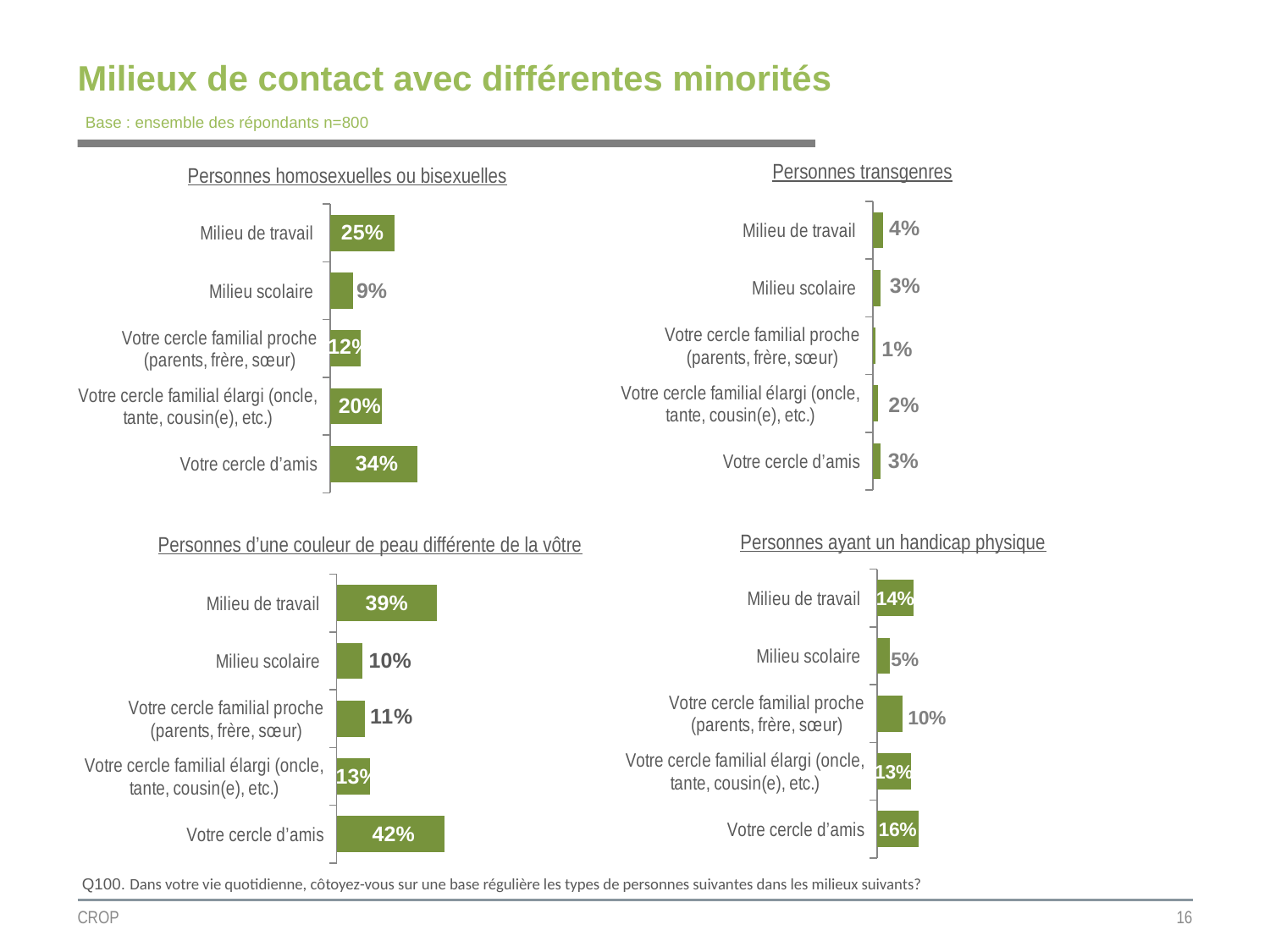
In the 'Personnes homosexuelles ou bisexuelles' chart, what is the value for 'Votre cercle d'amis'? 34% In the 'Personnes transgenres' chart, which category has the lowest value? Votre cercle familial proche (parents, frère, sœur) In the 'Personnes d'une couleur de peau différente de la vôtre' chart, which category has the highest value? Votre cercle d'amis How many charts are shown on the slide? 4 In the 'Personnes d'une couleur de peau différente de la vôtre' chart, what is the value for 'Milieu de travail'? 39% What type of chart is used for 'Personnes ayant un handicap physique'? Bar chart In the 'Personnes ayant un handicap physique' chart, what is the value for 'Milieu scolaire'? 5% In the 'Personnes transgenres' chart, what is the value for 'Milieu de travail'? 4% How many categories are shown in the 'Personnes transgenres' chart? 5 In the 'Personnes homosexuelles ou bisexuelles' chart, what is the difference between 'Votre cercle d'amis' and 'Milieu de travail'? 9% In the 'Personnes ayant un handicap physique' chart, what is the difference between 'Votre cercle d'amis' and 'Milieu de travail'? 2% In the 'Personnes d'une couleur de peau différente de la vôtre' chart, which is larger: 'Milieu scolaire' or 'Votre cercle familial élargi (oncle, tante, cousin(e), etc.)'? Votre cercle familial élargi (oncle, tante, cousin(e), etc.)